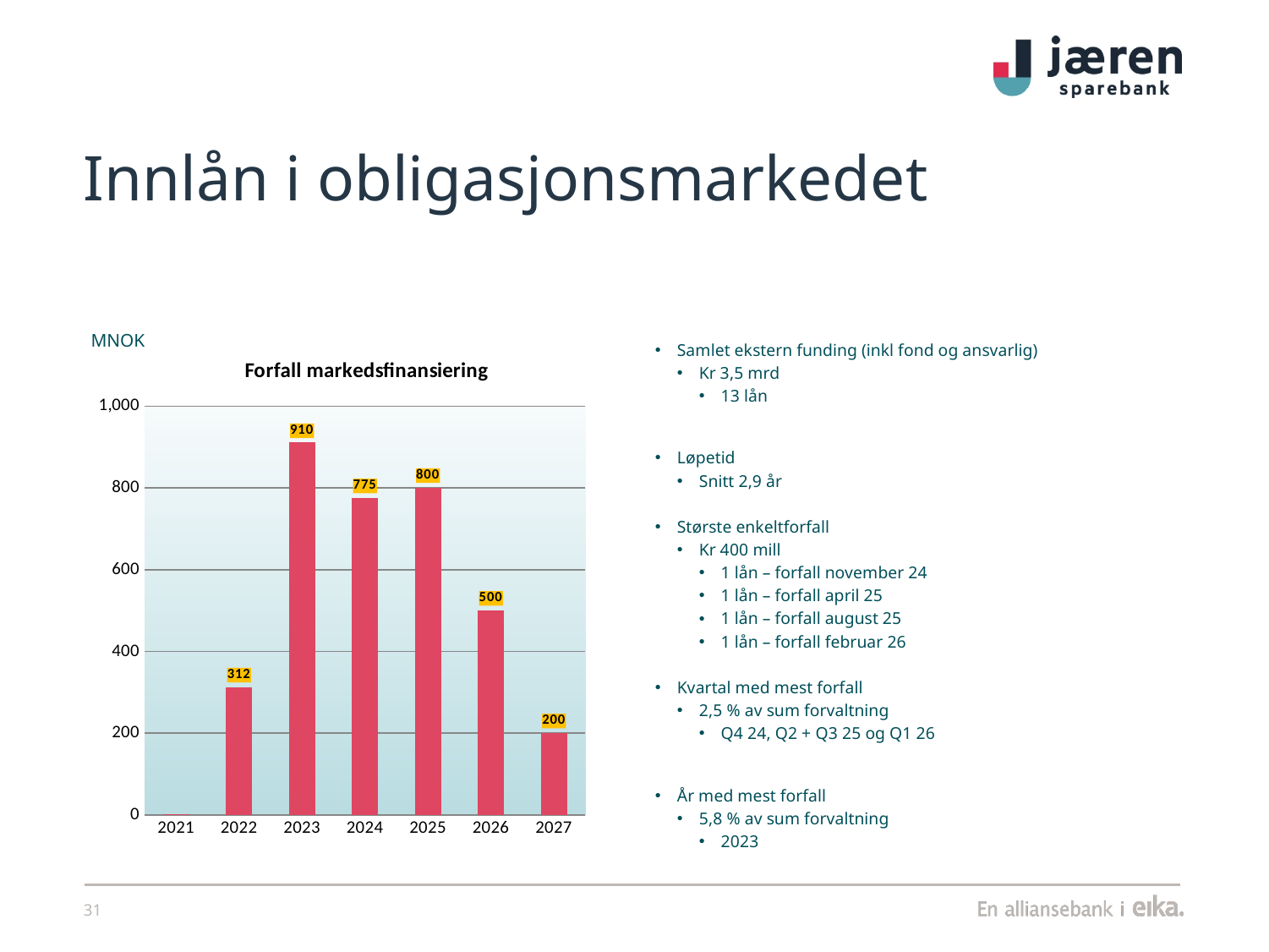
What is the difference between the values for 2023 and 2027 in the Forfall markedsfinansiering chart? 710 Is the value for 2024 in the Forfall markedsfinansiering chart greater or less than 600? greater What unit is indicated above the Forfall markedsfinansiering chart? MNOK What is the difference between the values for 2025 and 2024 in the Forfall markedsfinansiering chart? 25 What is the value for 2023 in the Forfall markedsfinansiering chart? 910 What is the value for 2026 in the Forfall markedsfinansiering chart? 500 How many years are shown on the x axis of the Forfall markedsfinansiering chart? 7 Which year has the highest value in the Forfall markedsfinansiering chart? 2023 What is the value for 2022 in the Forfall markedsfinansiering chart? 312 What kind of chart is the Forfall markedsfinansiering chart? bar chart Which year with a labelled bar has the lowest value in the Forfall markedsfinansiering chart? 2027 Which is larger in the Forfall markedsfinansiering chart, the value for 2022 or the value for 2026? 2026